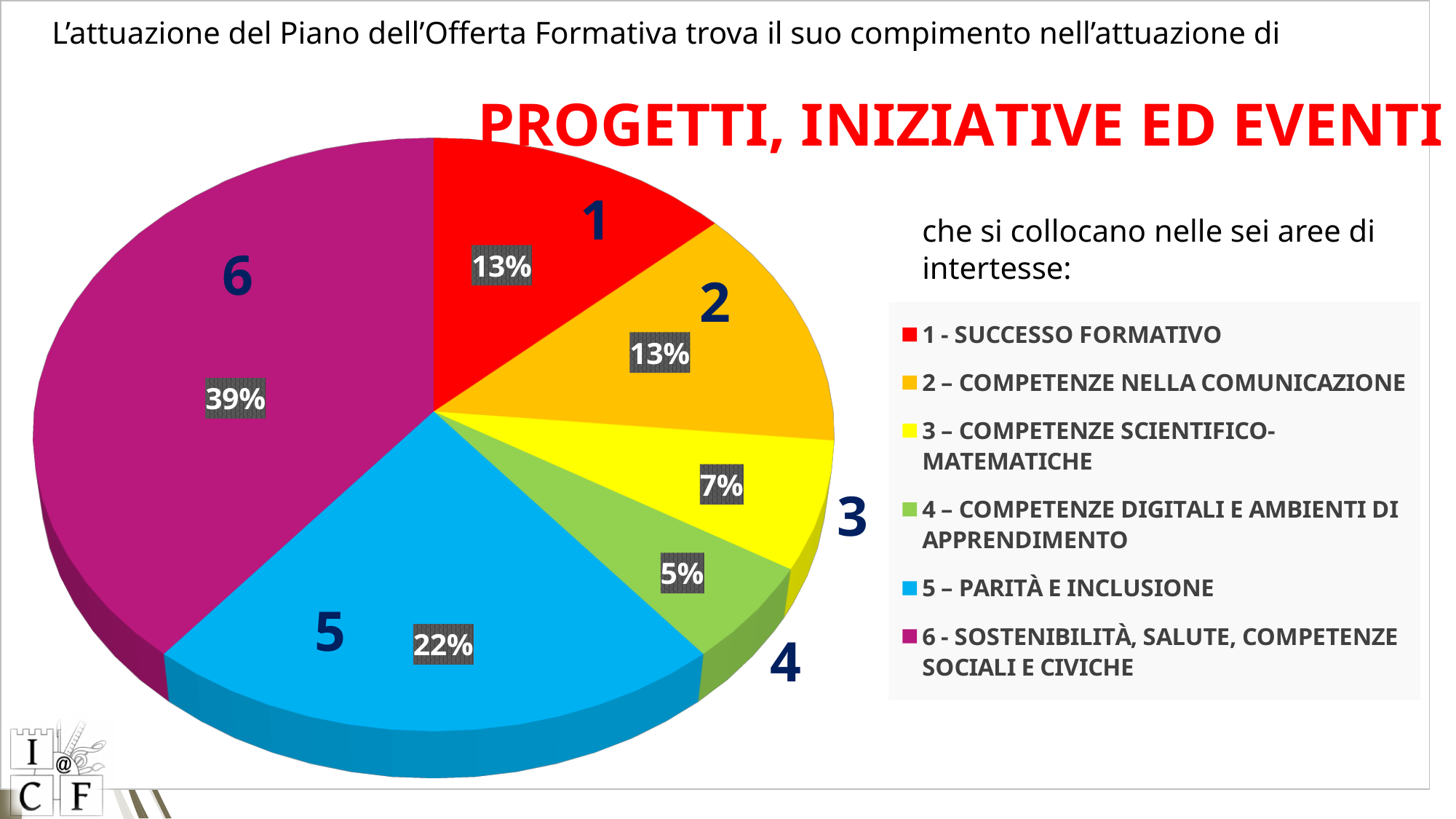
What percentage is shown for slice 3 (Competenze scientifico-matematiche)? 7% What colour is the slice for 2 – Competenze nella comunicazione? orange What percentage is shown for slice 6 (Sostenibilità, salute, competenze sociali e civiche)? 39% What percentage is shown for slice 1 (Successo formativo)? 13% Which slice has the largest share of the pie? 6 - Sostenibilità, salute, competenze sociali e civiche Which slice has the smallest share of the pie? 4 – Competenze digitali e ambienti di apprendimento What kind of chart is shown on the slide? pie chart Which is larger, the share for slice 5 (Parità e inclusione) or slice 1 (Successo formativo)? 5 – Parità e inclusione How many slices does the pie chart have? 6 What percentage is shown for slice 5 (Parità e inclusione)? 22% What percentage is shown for slice 4 (Competenze digitali e ambienti di apprendimento)? 5% What is the difference in percentage points between slice 6 and slice 5? 17